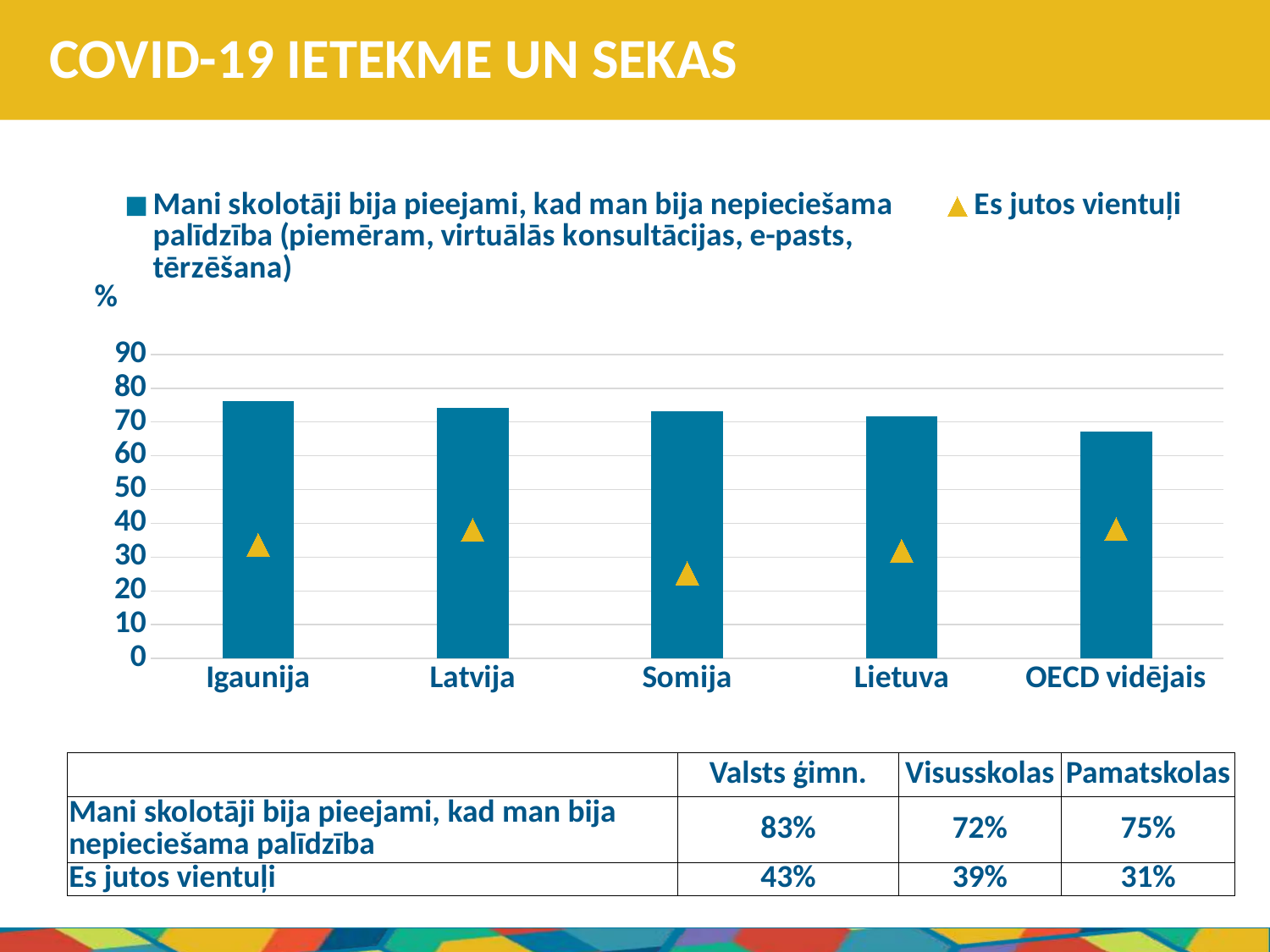
Which category has the lowest bar for 'Mani skolotāji bija pieejami, kad man bija nepieciešama palīdzība'? OECD vidējais Which category has the highest bar for 'Mani skolotāji bija pieejami, kad man bija nepieciešama palīdzība'? Igaunija How many countries or categories are shown on the x axis of the chart? 5 What unit label is shown on the vertical axis of the chart? % Which category has the lowest value for 'Es jutos vientuļi'? Somija Is the 'Es jutos vientuļi' value for Somija greater or less than 30? less Is the bar value for OECD vidējais greater or less than 70? less Is the 'Es jutos vientuļi' value for Latvija greater or less than 30? greater Do the bar values rise or fall moving from Igaunija to OECD vidējais along the x axis? fall How many series does the chart legend list? 2 What kind of chart is shown on the slide? A bar chart with a line/marker series (combination chart)